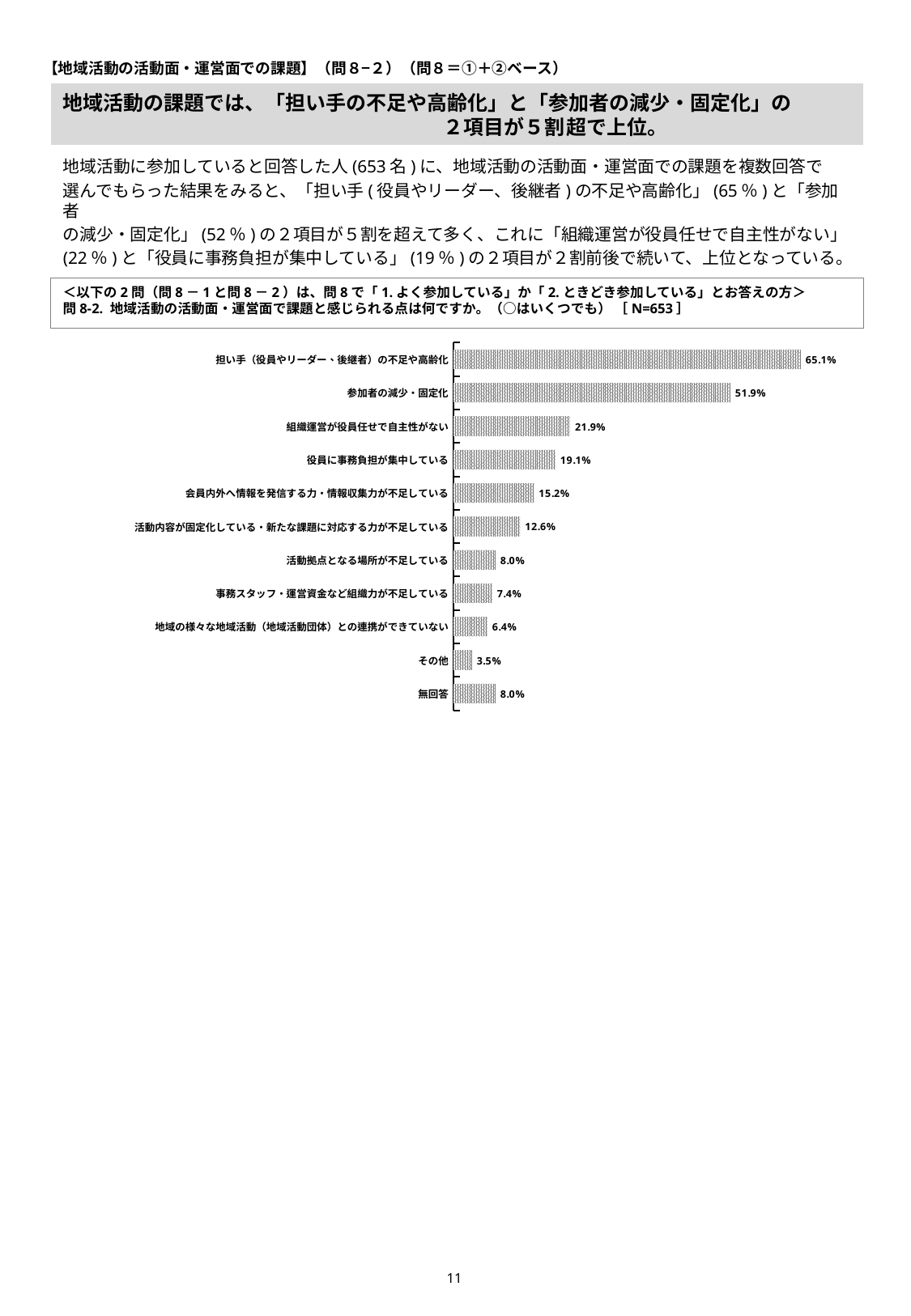
What is the difference between the values for 活動拠点となる場所が不足している and 事務スタッフ・運営資金など組織力が不足している? 0.6 percentage points Which is larger: the value for 組織運営が役員任せで自主性がない or the value for 会員内外へ情報を発信する力・情報収集力が不足している? 組織運営が役員任せで自主性がない What is the value for 無回答? 8.0% What is the difference between the values for 担い手（役員やリーダー、後継者）の不足や高齢化 and 参加者の減少・固定化? 13.2 percentage points What is the value for 参加者の減少・固定化? 51.9% What is the value for 担い手（役員やリーダー、後継者）の不足や高齢化? 65.1% What is the value for 役員に事務負担が集中している? 19.1% Which category has the highest value? 担い手（役員やリーダー、後継者）の不足や高齢化 Which category has the lowest value? その他 What type of chart is shown on the slide? Bar chart What is the sample size (N) stated in the question box above the chart? N=653 How many categories are plotted in the chart? 11